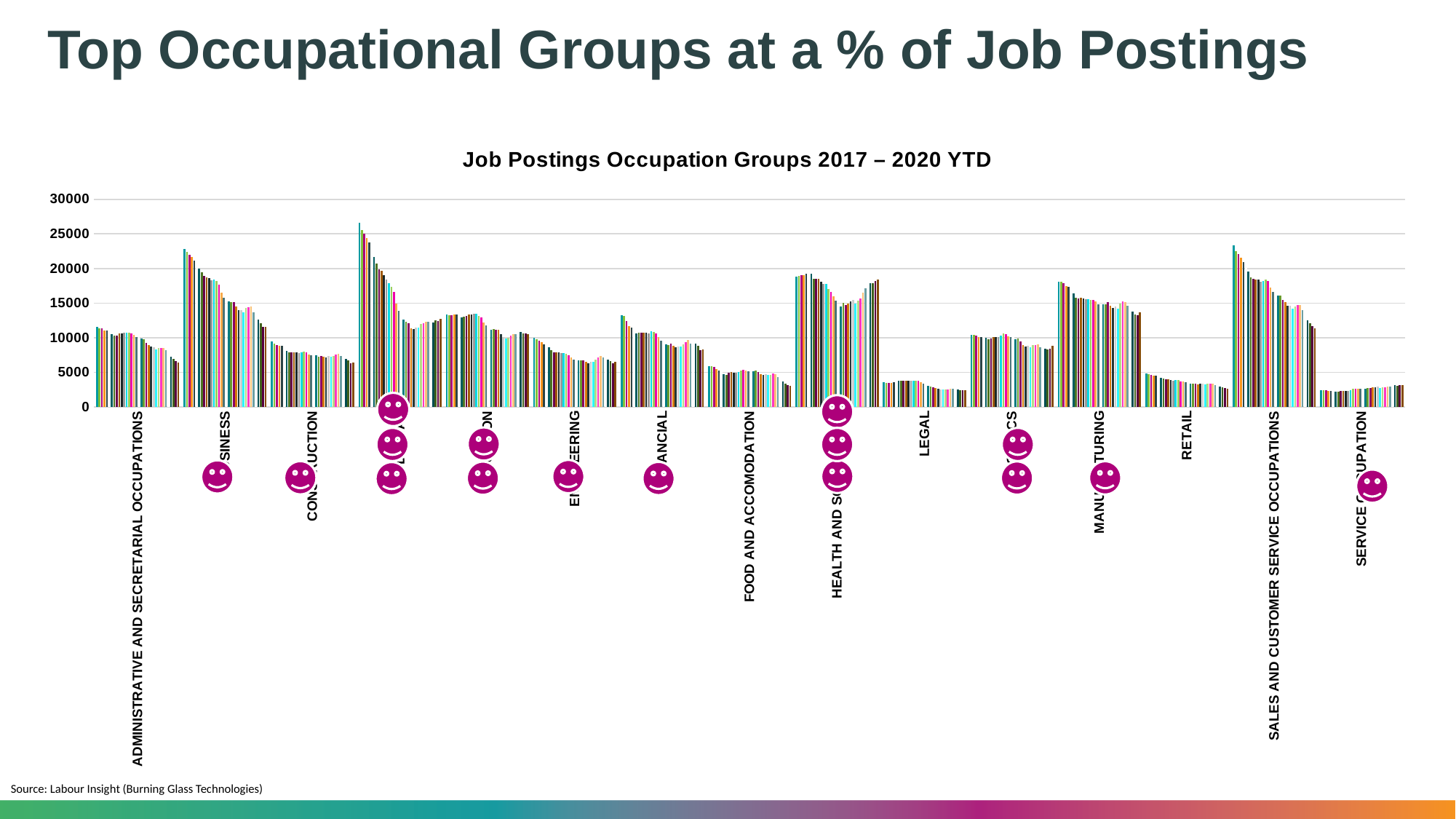
Is the tallest bar for SALES AND CUSTOMER SERVICE OCCUPATIONS greater or less than 20000? greater Are the bars for RETAIL greater or less than 10000? less Which group has taller bars, SALES AND CUSTOMER SERVICE OCCUPATIONS or LEGAL? SALES AND CUSTOMER SERVICE OCCUPATIONS Is the tallest bar for ADMINISTRATIVE AND SECRETARIAL OCCUPATIONS greater or less than 10000? greater Which group has taller bars, ADMINISTRATIVE AND SECRETARIAL OCCUPATIONS or RETAIL? ADMINISTRATIVE AND SECRETARIAL OCCUPATIONS What is the title of the chart? Job Postings Occupation Groups 2017 – 2020 YTD What is the highest value shown on the vertical axis of the chart? 30000 Which group has taller bars, FOOD AND ACCOMODATION or SALES AND CUSTOMER SERVICE OCCUPATIONS? SALES AND CUSTOMER SERVICE OCCUPATIONS Within the SALES AND CUSTOMER SERVICE OCCUPATIONS group, do the bars generally rise or fall from left to right? fall What kind of chart is shown on the slide? Bar chart